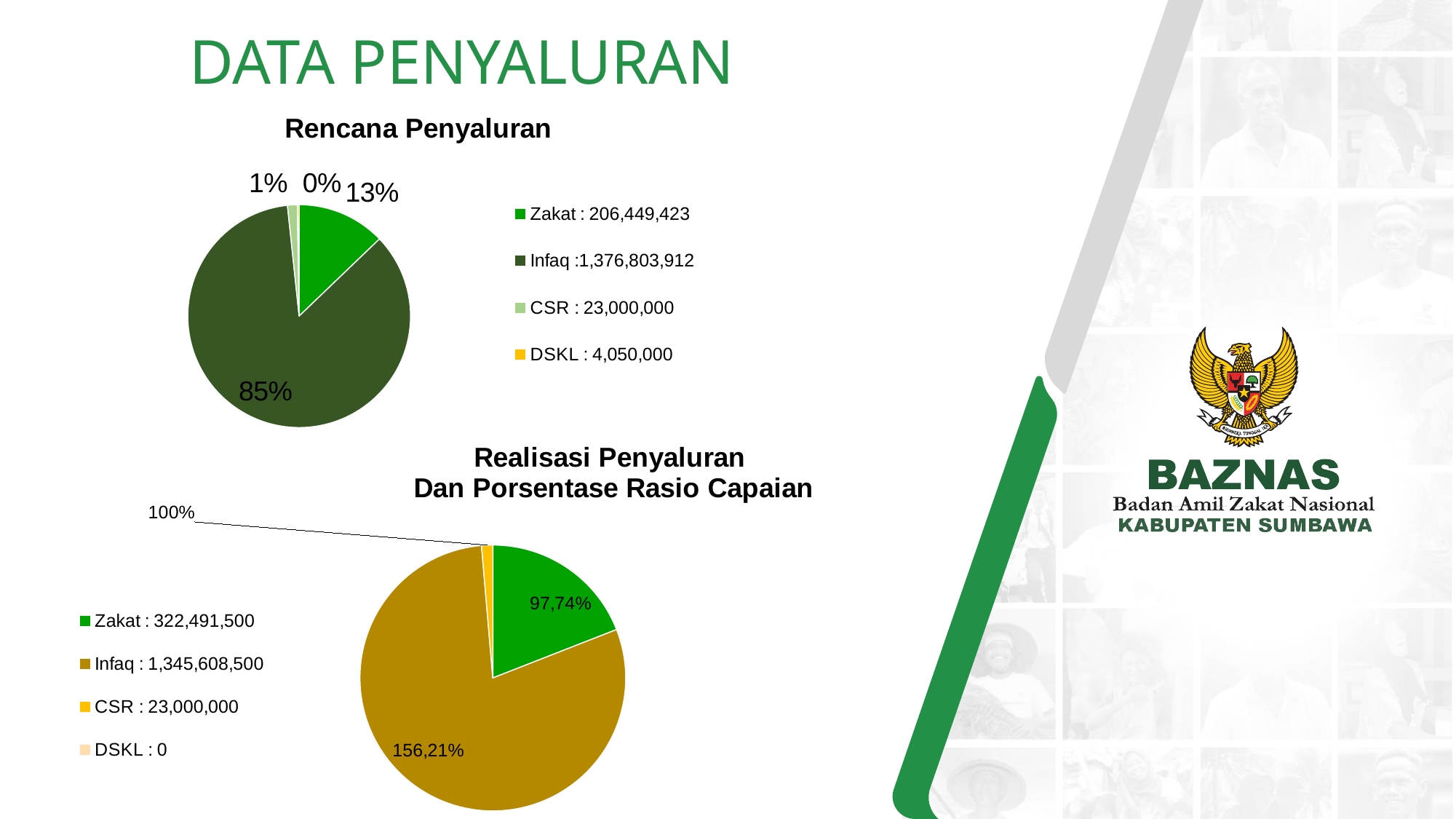
In the "Realisasi Penyaluran Dan Porsentase Rasio Capaian" chart, what percentage label is shown on the Zakat slice? 97,74% In the "Realisasi Penyaluran Dan Porsentase Rasio Capaian" chart, what percentage label is shown on the Infaq slice? 156,21% What kind of chart is the "Rencana Penyaluran" chart? pie chart In the "Rencana Penyaluran" chart, what value does the legend give for DSKL? 4,050,000 How many categories does the legend of the "Rencana Penyaluran" chart list? 4 In the "Realisasi Penyaluran Dan Porsentase Rasio Capaian" chart, which category has the smallest legend value? DSKL In the "Rencana Penyaluran" chart, what value does the legend give for Infaq? 1,376,803,912 In the "Rencana Penyaluran" chart, what share of the pie does Zakat take? 13% In the "Realisasi Penyaluran Dan Porsentase Rasio Capaian" chart, what value does the legend give for Zakat? 322,491,500 In the "Realisasi Penyaluran Dan Porsentase Rasio Capaian" chart, which is larger, the legend value for Zakat or for CSR? Zakat In the "Rencana Penyaluran" chart, what share of the pie does Infaq take? 85% In the "Rencana Penyaluran" chart, which category has the largest slice? Infaq